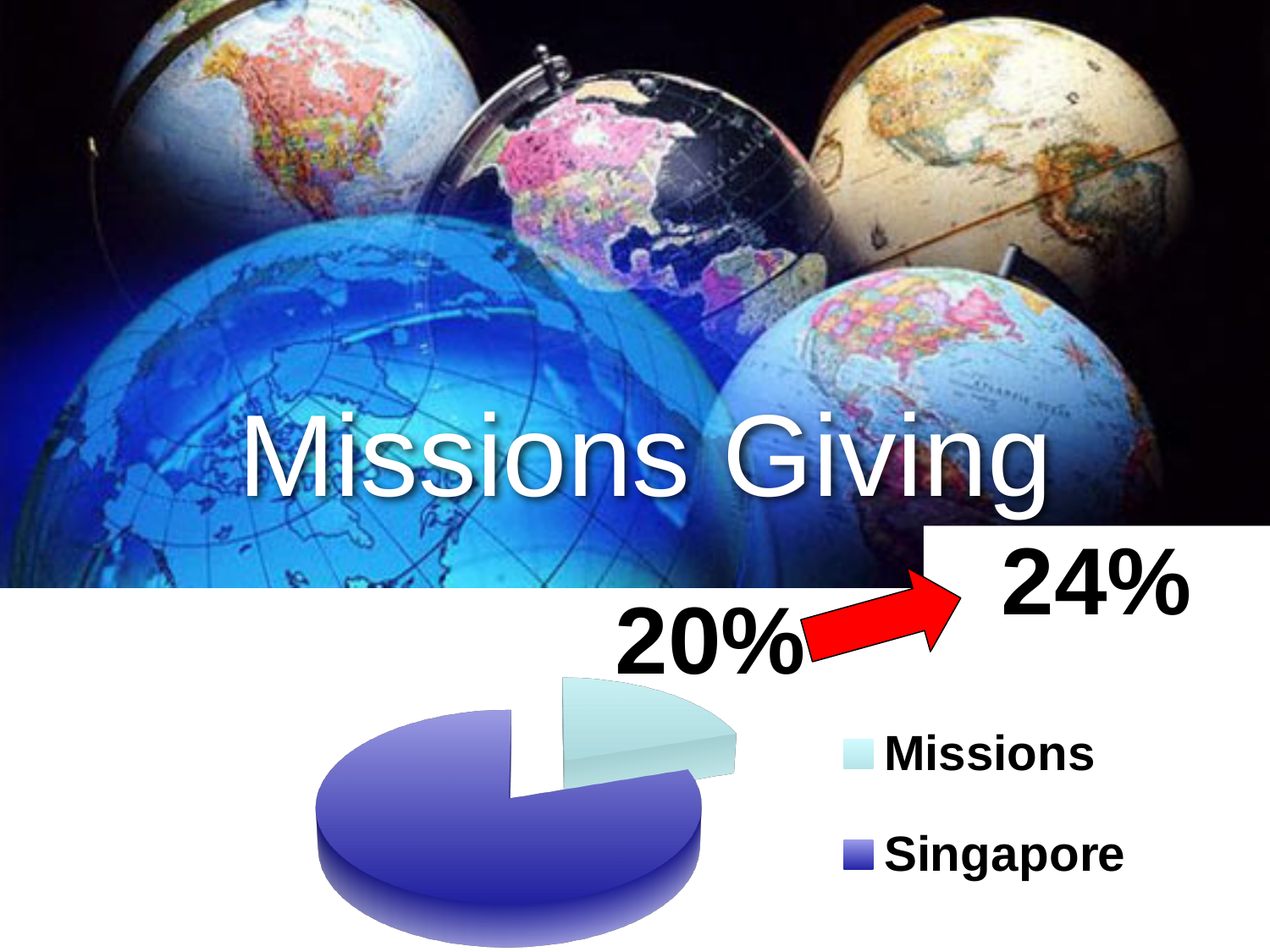
Which legend entry in the pie chart is shown in light cyan? Missions What kind of chart is shown on the slide? pie chart What percentage is labelled on the Missions slice of the pie chart? 20% What share of the pie does the Missions slice represent? 20% What percentage does the red arrow next to the pie chart point to? 24% Which category has the smallest slice in the pie chart? Missions How many entries does the legend of the pie chart list? 2 What is the title of the slide containing the pie chart? Missions Giving Which category has the largest slice in the pie chart? Singapore Which slice of the pie chart is larger, Missions or Singapore? Singapore How many slices does the pie chart have? 2